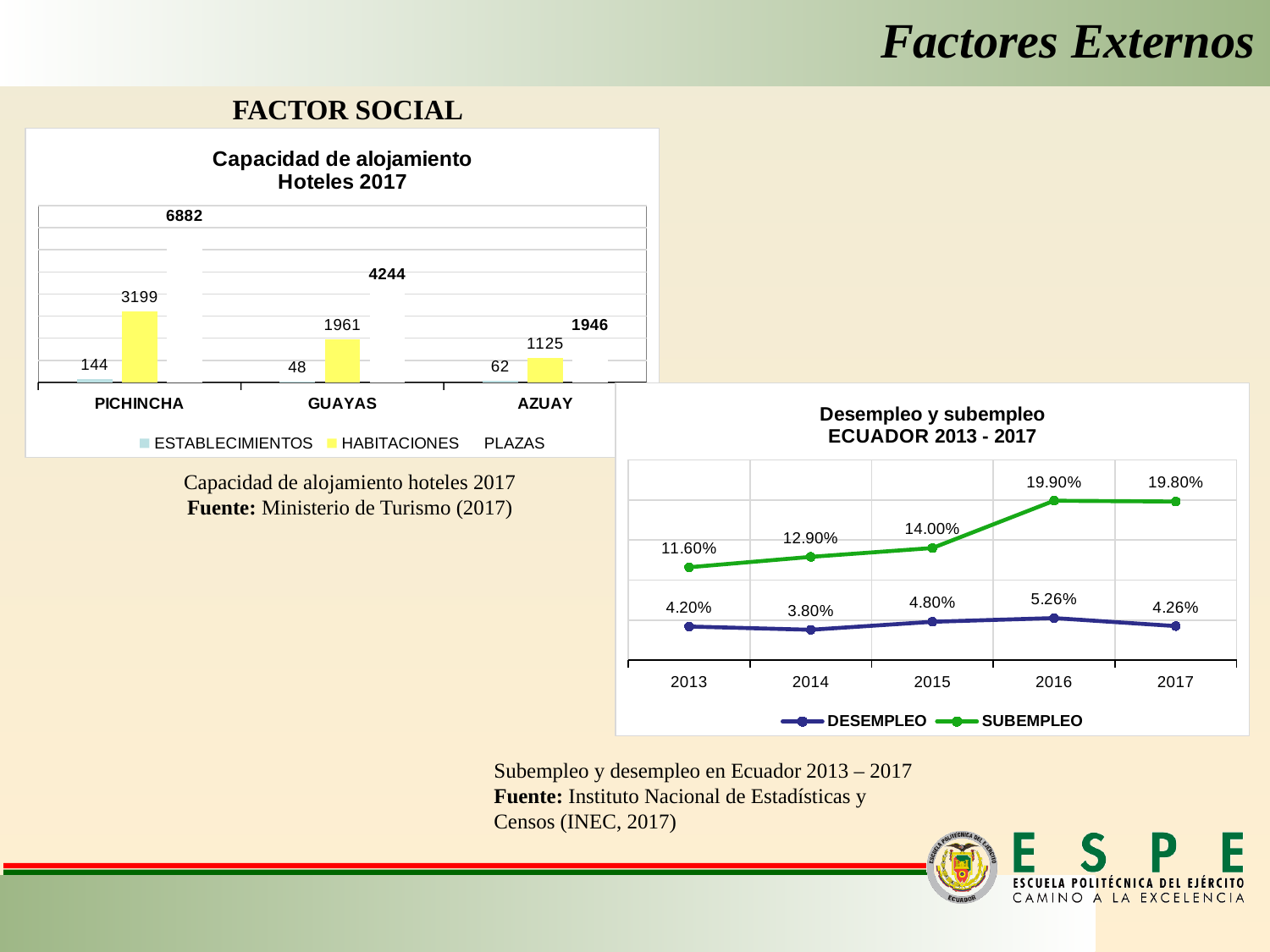
In the 'Desempleo y subempleo ECUADOR 2013 - 2017' chart, how many years are plotted on the x axis? 5 In the 'Capacidad de alojamiento Hoteles 2017' chart, how many series does the legend list? 3 In the 'Desempleo y subempleo ECUADOR 2013 - 2017' chart, in which year is DESEMPLEO highest? 2016 What kind of chart is 'Capacidad de alojamiento Hoteles 2017'? Bar chart In the 'Capacidad de alojamiento Hoteles 2017' chart, what is the value of ESTABLECIMIENTOS for GUAYAS? 48 In the 'Desempleo y subempleo ECUADOR 2013 - 2017' chart, what is the SUBEMPLEO value for 2016? 19.90% In the 'Capacidad de alojamiento Hoteles 2017' chart, what is the difference between the PLAZAS values for PICHINCHA and GUAYAS? 2638 In the 'Desempleo y subempleo ECUADOR 2013 - 2017' chart, in which year is SUBEMPLEO lowest? 2013 In the 'Desempleo y subempleo ECUADOR 2013 - 2017' chart, what is the DESEMPLEO value for 2014? 3.80% In the 'Capacidad de alojamiento Hoteles 2017' chart, what is the value of HABITACIONES for PICHINCHA? 3199 What kind of chart is 'Desempleo y subempleo ECUADOR 2013 - 2017'? Line chart In the 'Capacidad de alojamiento Hoteles 2017' chart, which province has the highest PLAZAS value? PICHINCHA